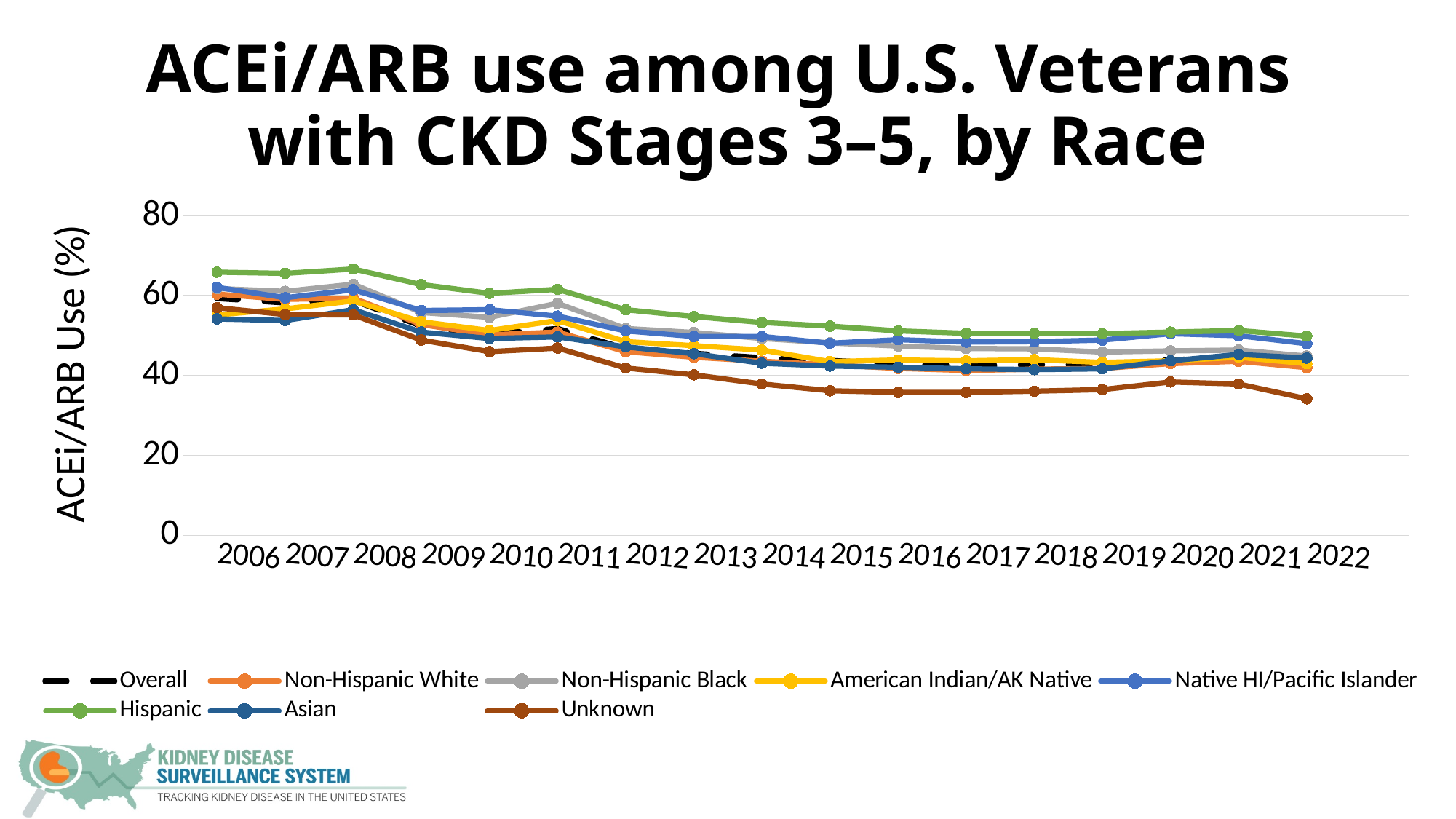
Is the value for Hispanic in 2022 greater or less than 60? less What is the label on the y axis? ACEi/ARB Use (%) What kind of chart is shown on the slide? line chart In 2014, which is larger: the value for Hispanic or the value for Unknown? Hispanic Is the value for Hispanic in 2006 greater or less than 60? greater How many years are plotted along the x axis? 17 Which series has the highest ACEi/ARB use in 2006? Hispanic Is the value for Unknown in 2022 greater or less than 40? less How many series does the legend list? 8 Does the Hispanic series generally rise or fall from 2006 to 2022? fall Which series has the lowest ACEi/ARB use in 2022? Unknown